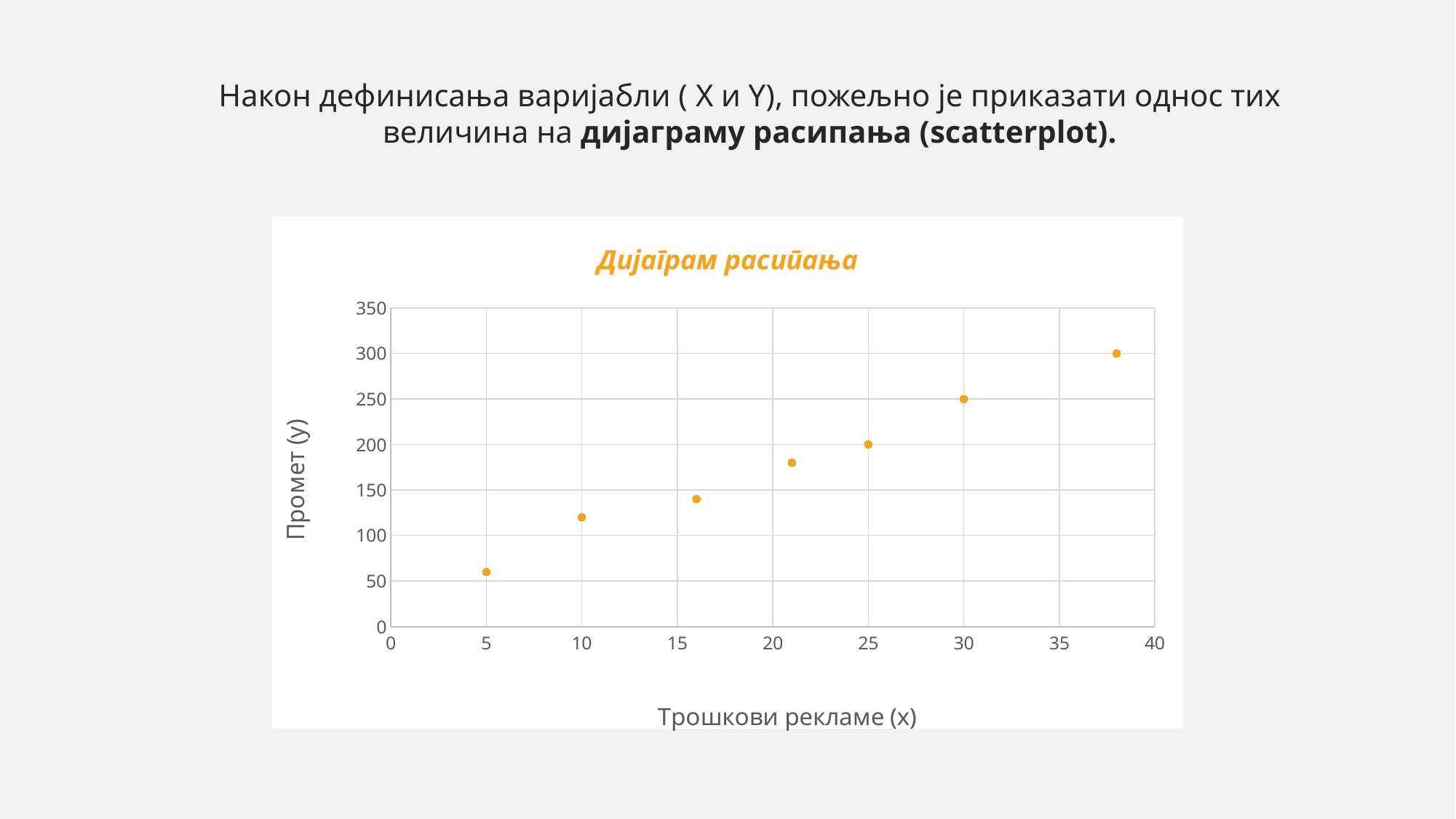
Is the Промет (y) value of the point at x = 5 greater or less than 100? less Do the Промет (y) values rise or fall as Трошкови рекламе (x) increases? rise How many data points are plotted in the chart? 7 What is the Промет (y) value of the rightmost point in the chart? 300 What kind of chart is shown on the slide? scatter plot Which point has a higher Промет (y) value: the one at x = 25 or the one at x = 30? x = 30 What is the label of the horizontal axis of the chart? Трошкови рекламе (x) What is the difference in Промет (y) between the points at x = 30 and x = 25? 50 Is the Промет (y) value of the point at x = 10 greater or less than 100? greater What is the Промет (y) value of the point at Трошкови рекламе (x) = 30? 250 What is the title of the chart? Дијаграм расипања What is the Промет (y) value of the point at Трошкови рекламе (x) = 25? 200